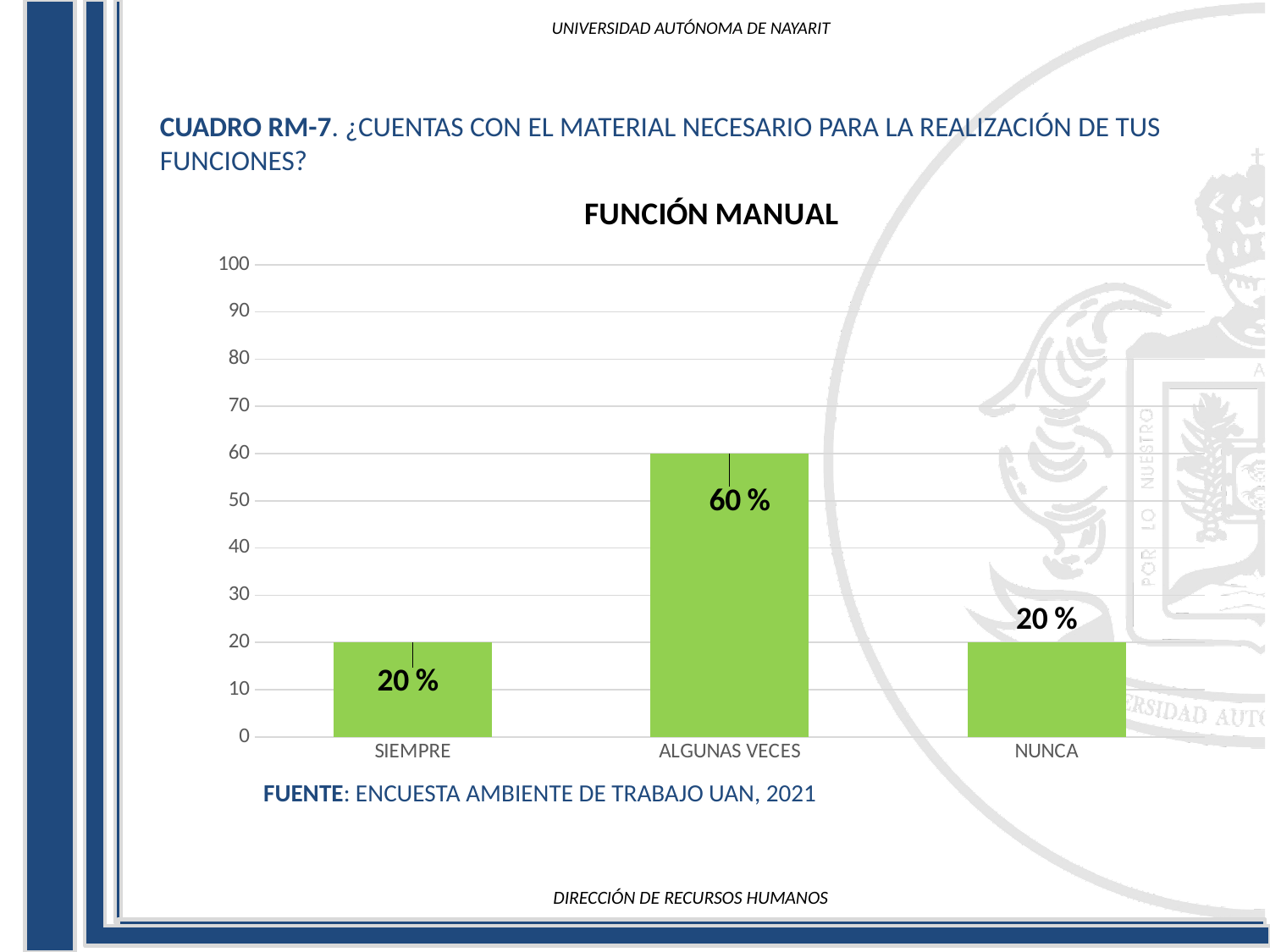
What is the title of the chart? FUNCIÓN MANUAL How many categories are shown on the x axis? 3 Which is larger, the value for ALGUNAS VECES or the value for NUNCA? ALGUNAS VECES What is the maximum value shown on the y axis? 100 What is the value for SIEMPRE? 20 % What is the value for ALGUNAS VECES? 60 % What is the value for NUNCA? 20 % Is the value for ALGUNAS VECES greater or less than 50? greater Which category has the highest value? ALGUNAS VECES What kind of chart is shown on the slide? bar chart What is the difference between the values for ALGUNAS VECES and SIEMPRE? 40 % Is the value for SIEMPRE greater or less than 30? less